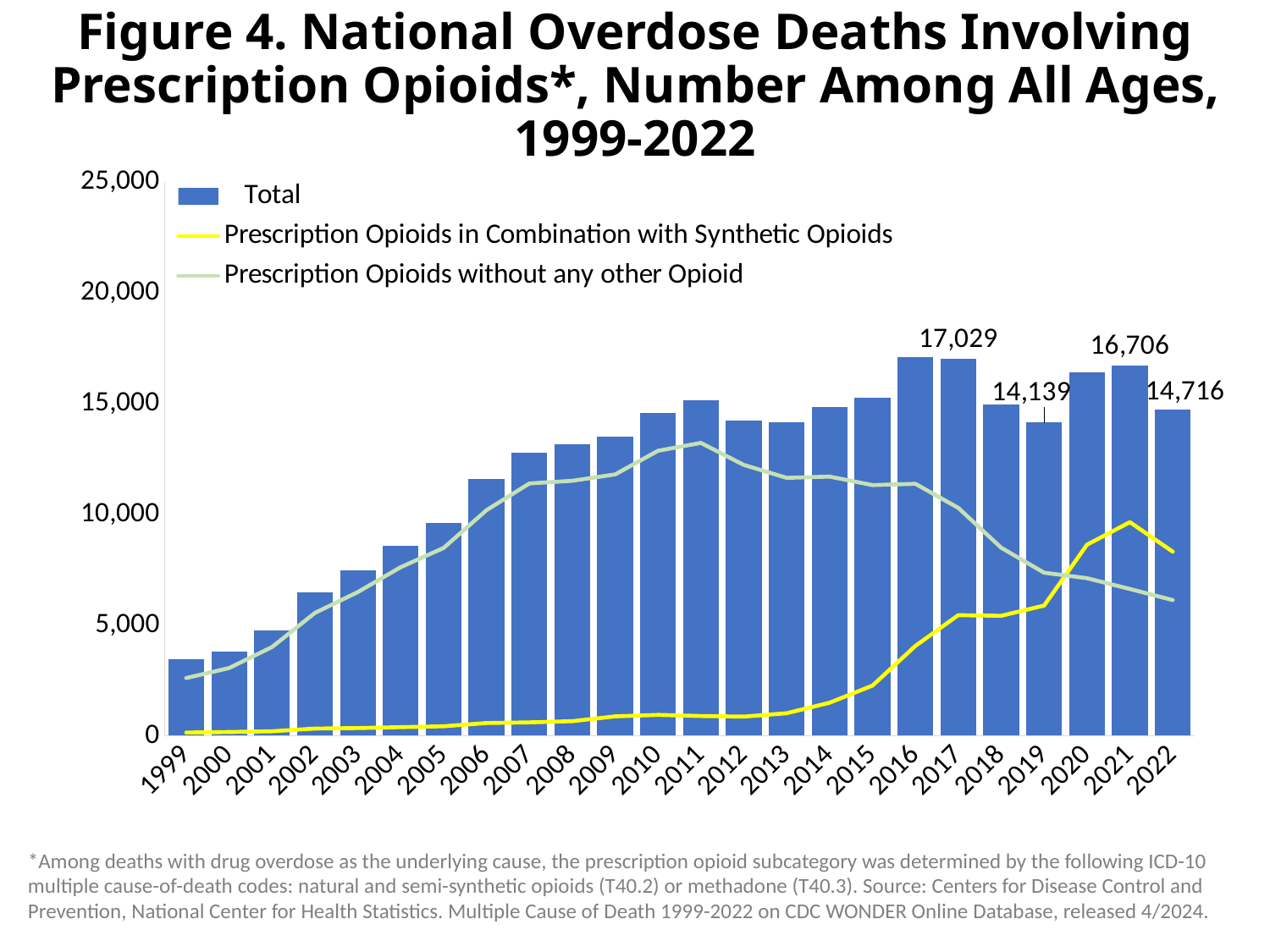
What is the Total value for 2019? 14,139 Is the Total value for 2005 greater or less than 10,000? less How many years are shown on the x axis? 24 How many series does the legend list? 3 What is the difference between the Total values for 2021 and 2022? 1,990 Which year has the lowest Total bar? 1999 Does the Prescription Opioids without any other Opioid line rise or fall from 2011 to 2022? fall In 2022, which line is higher: Prescription Opioids in Combination with Synthetic Opioids or Prescription Opioids without any other Opioid? Prescription Opioids in Combination with Synthetic Opioids What is the difference between the Total values for 2022 and 2019? 577 Which is larger, the Total for 2021 or the Total for 2022? 2021 What is the Total value for 2022? 14,716